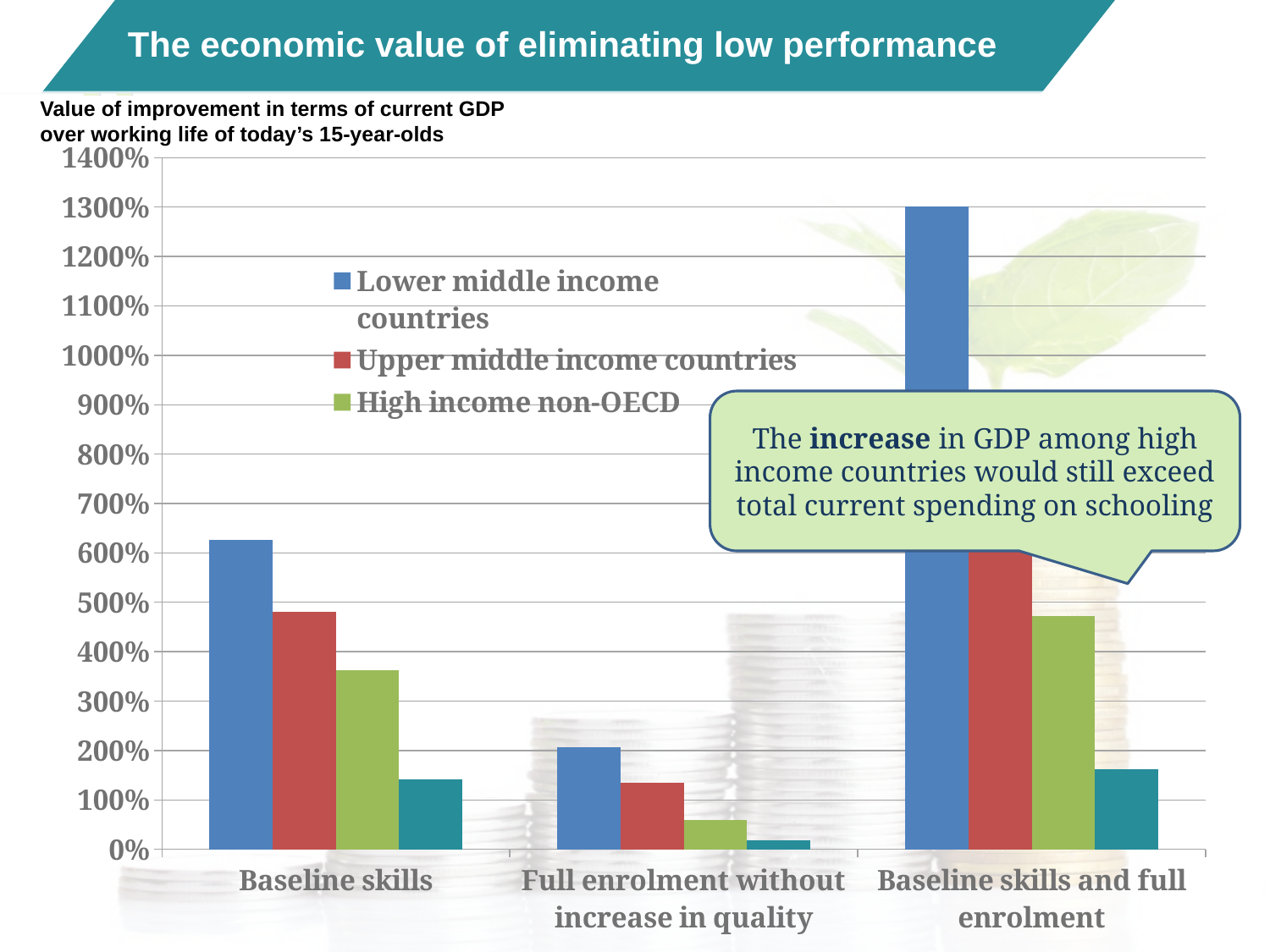
What is the highest value shown on the y axis of the chart? 1400% Which is larger for Upper middle income countries: the value under Baseline skills or under Full enrolment without increase in quality? Baseline skills In which category is the Upper middle income countries bar the lowest? Full enrolment without increase in quality Is the value for Lower middle income countries under Baseline skills and full enrolment greater or less than 1200%? greater How many categories are shown on the x axis of the chart? 3 Is the value for Lower middle income countries under Baseline skills greater or less than 500%? greater Is the value for Upper middle income countries under Baseline skills greater or less than 400%? greater Under Baseline skills, which is larger: Lower middle income countries or High income non-OECD? Lower middle income countries In which category is the Lower middle income countries bar the highest? Baseline skills and full enrolment What kind of chart is shown on the slide? bar chart